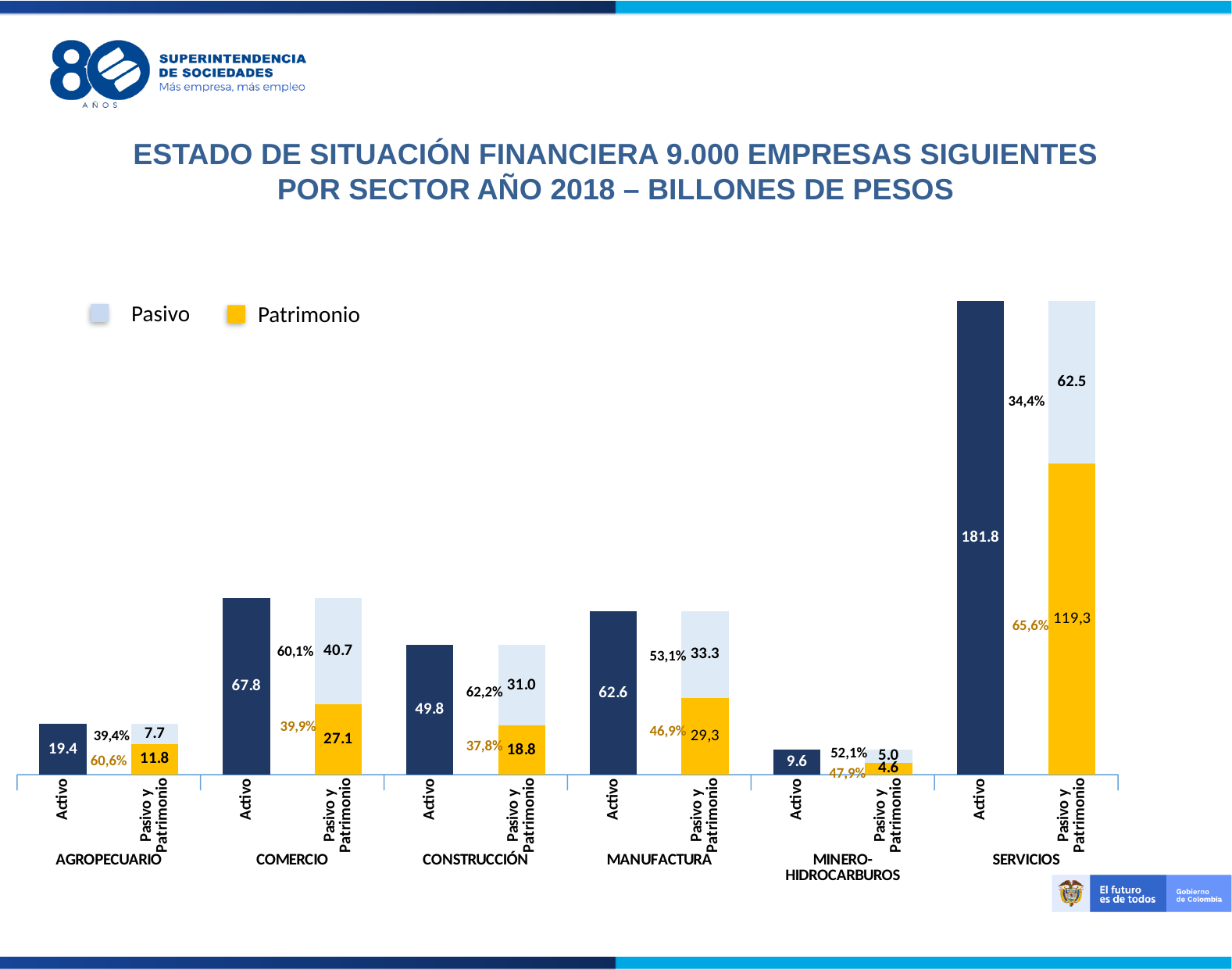
What is the Patrimonio value for the COMERCIO sector? 27.1 What is the total of the Pasivo y Patrimonio stacked bar for the MINERO-HIDROCARBUROS sector? 9.6 Which sector has the larger Activo value, COMERCIO or MANUFACTURA? COMERCIO How many sectors are shown on the chart? 6 What is the Activo value for the SERVICIOS sector? 181.8 In the CONSTRUCCIÓN sector, what is the difference between the Pasivo value and the Patrimonio value? 12.2 What is the Pasivo value for the MANUFACTURA sector? 33.3 What kind of chart is shown on the slide? Bar chart How many series does the legend list? 2 What percentage is shown for Pasivo in the AGROPECUARIO sector? 39,4% Which sector has the highest Activo value? SERVICIOS Which sector has the lowest Activo value? MINERO-HIDROCARBUROS